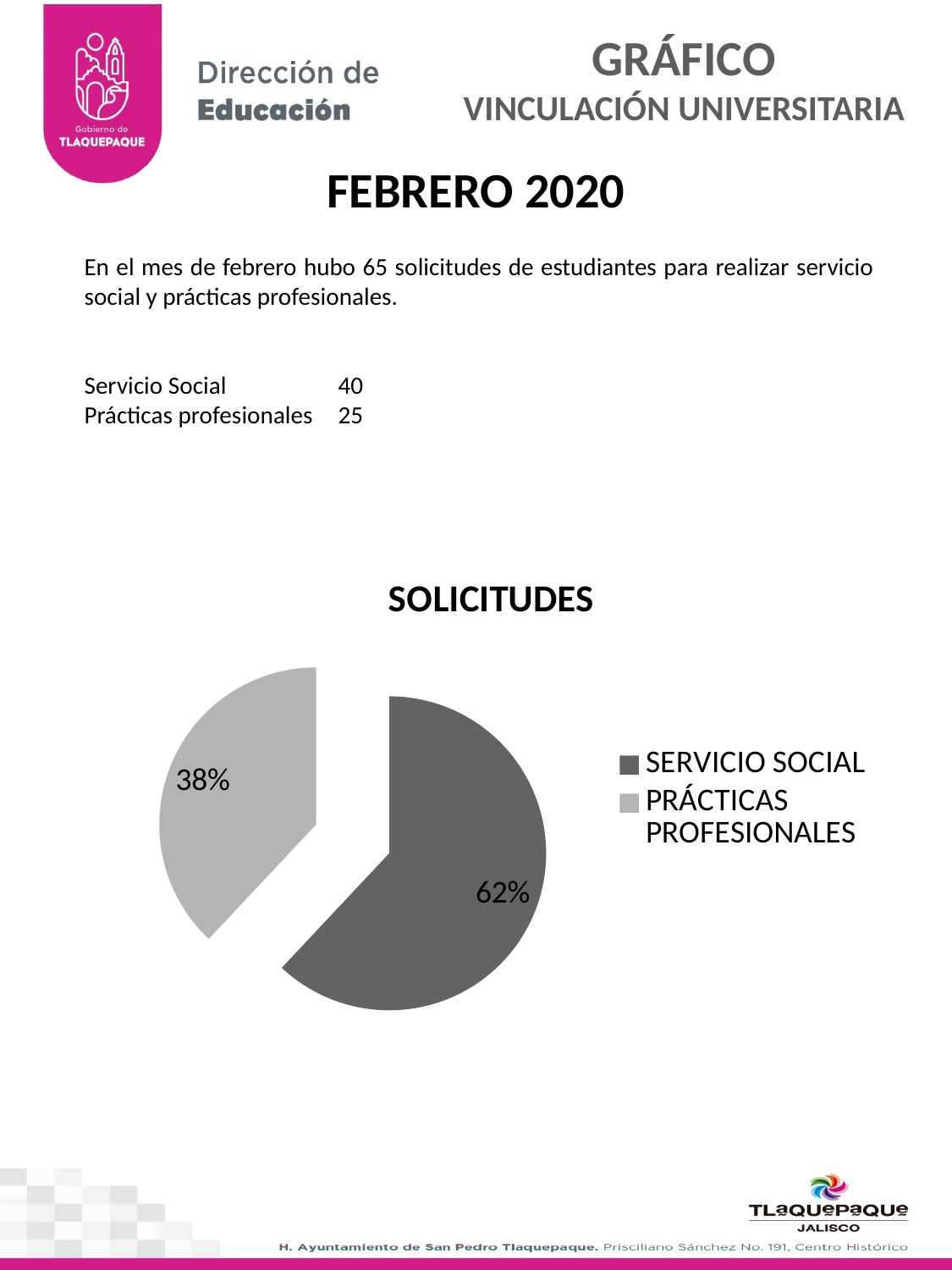
What percentage does the PRÁCTICAS PROFESIONALES slice show? 38% What is the difference in percentage points between the SERVICIO SOCIAL and PRÁCTICAS PROFESIONALES slices? 24% Which slice is the largest in the pie chart? SERVICIO SOCIAL How many slices does the pie chart have? 2 What is the title of the chart? SOLICITUDES What percentage does the SERVICIO SOCIAL slice show? 62% What kind of chart is shown under the title SOLICITUDES? pie chart Which is larger, the SERVICIO SOCIAL slice or the PRÁCTICAS PROFESIONALES slice? SERVICIO SOCIAL What share of the pie does SERVICIO SOCIAL represent? 62% Which legend entry is shown in the lighter grey colour? PRÁCTICAS PROFESIONALES How many entries does the legend list? 2 Which slice is the smallest in the pie chart? PRÁCTICAS PROFESIONALES